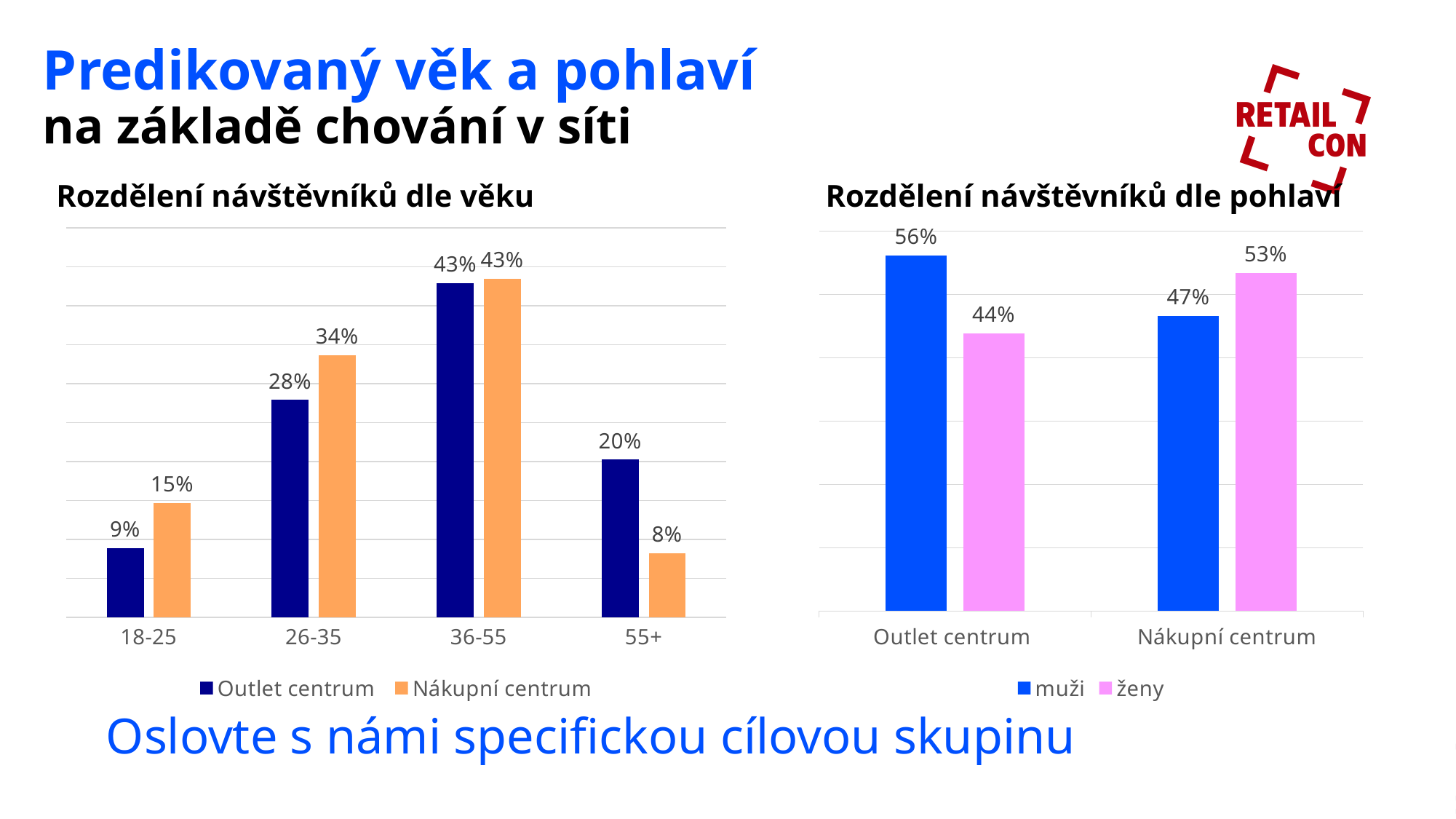
What type of chart is 'Rozdělení návštěvníků dle pohlaví'? Bar chart In the chart 'Rozdělení návštěvníků dle věku', which age group has the highest value for Nákupní centrum? 36-55 In the chart 'Rozdělení návštěvníků dle věku', what is the value for Outlet centrum in the 26-35 age group? 28% In the chart 'Rozdělení návštěvníků dle věku', what is the value for Nákupní centrum in the 55+ age group? 8% In the chart 'Rozdělení návštěvníků dle věku', which is larger in the 55+ age group: Outlet centrum or Nákupní centrum? Outlet centrum In the chart 'Rozdělení návštěvníků dle pohlaví', what is the value for muži at Outlet centrum? 56% In the chart 'Rozdělení návštěvníků dle věku', what is the difference between Nákupní centrum and Outlet centrum in the 18-25 age group? 6% How many series does the legend of the chart 'Rozdělení návštěvníků dle pohlaví' list? 2 In the chart 'Rozdělení návštěvníků dle pohlaví', which series is shown in pink? ženy In the chart 'Rozdělení návštěvníků dle věku', which age group has the lowest value for Outlet centrum? 18-25 In the chart 'Rozdělení návštěvníků dle pohlaví', what is the difference between ženy and muži at Nákupní centrum? 6% How many age groups are shown in the chart 'Rozdělení návštěvníků dle věku'? 4